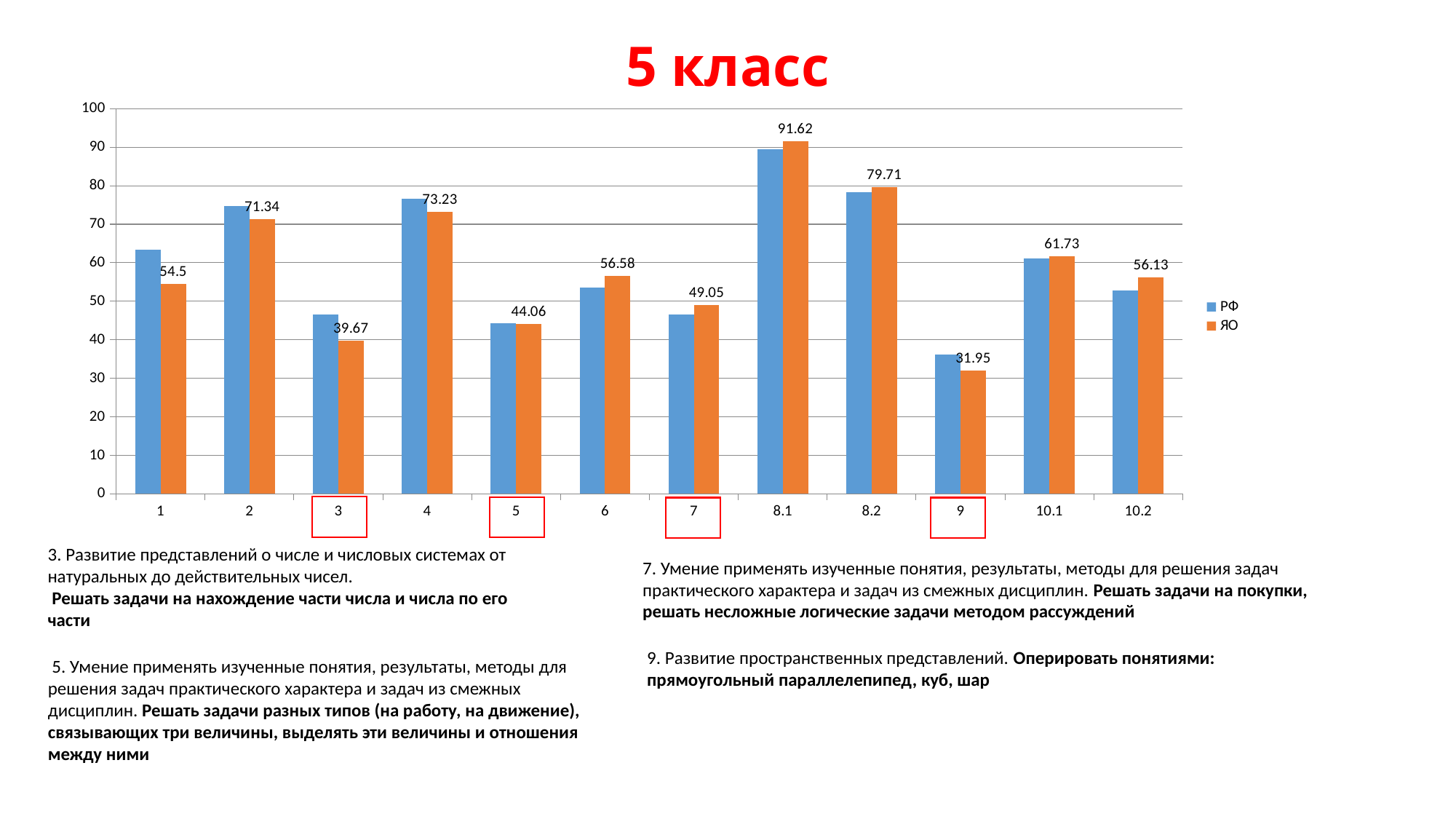
How many series does the legend list? 2 Which category has the highest ЯО value? 8.1 What is the value of the ЯО series for category 8.1? 91.62 Is the РФ value for category 9 greater or less than 40? less How many categories are shown on the x axis? 12 What type of chart is shown on the slide? bar chart Which category has the larger ЯО value, 2 or 4? 4 Which category has the lowest ЯО value? 9 Is the РФ value for category 1 greater or less than 60? greater What is the value of the ЯО series for category 3? 39.67 For category 1, which series has the larger value, РФ or ЯО? РФ What is the difference between the ЯО values for categories 8.1 and 8.2? 11.91